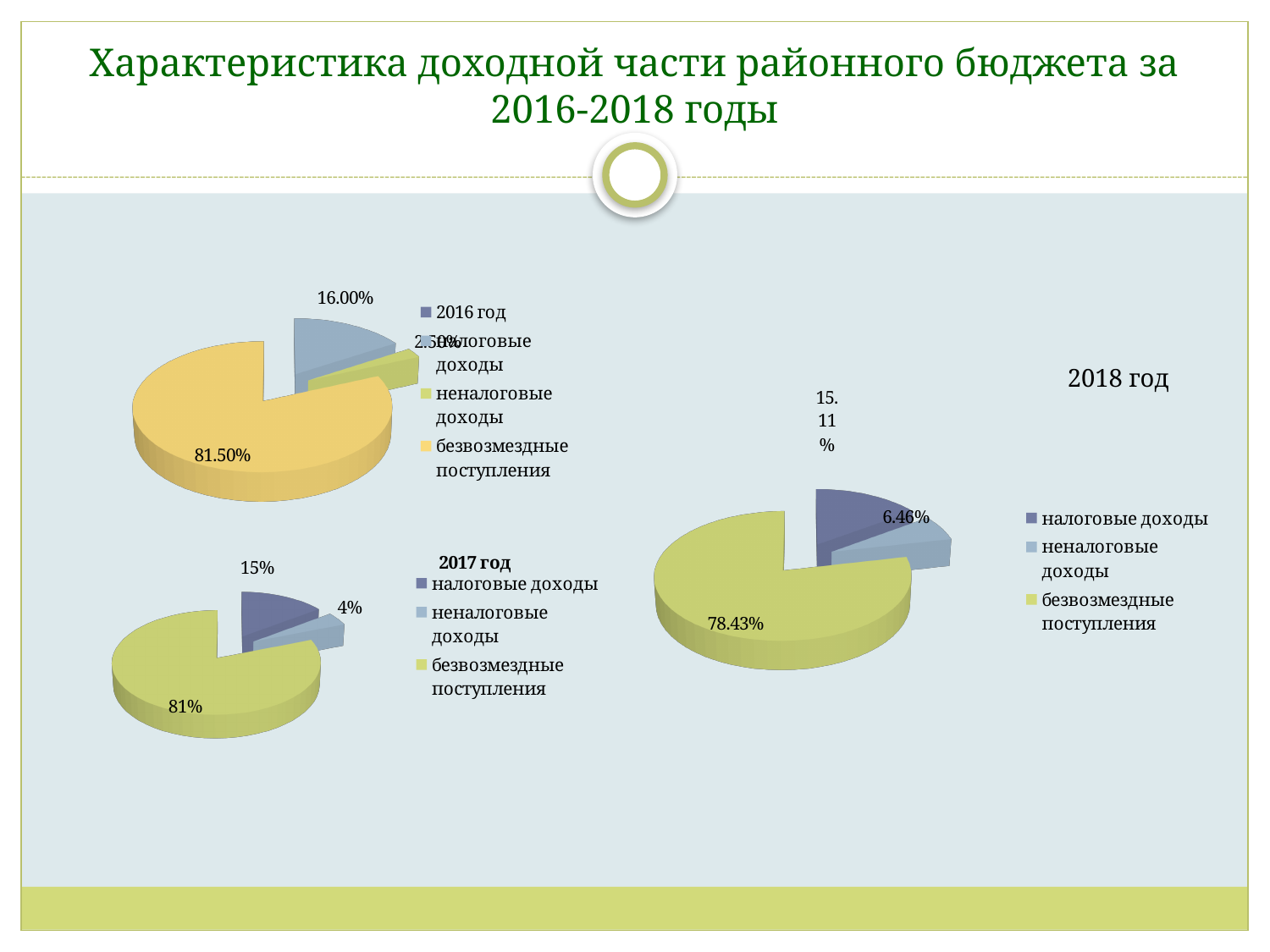
In the 2016 год pie chart, what is the share for безвозмездные поступления? 81.50% In the 2018 год pie chart, which category has the largest slice? безвозмездные поступления In the 2018 год pie chart, what is the difference between the shares of налоговые доходы and неналоговые доходы? 8.65% In the 2018 год pie chart, what is the share for налоговые доходы? 15.11% What type of chart is used for the 2018 год data? pie chart In the 2017 год pie chart, what is the share for налоговые доходы? 15% How many categories does the 2017 год pie chart show? 3 In the 2017 год pie chart, what is the share for неналоговые доходы? 4% In the 2017 год pie chart, what is the share for безвозмездные поступления? 81% In the 2016 год pie chart, what is the share for налоговые доходы? 16.00% In the 2017 год pie chart, which category has the smallest slice? неналоговые доходы In the 2018 год pie chart, what is the share for неналоговые доходы? 6.46%